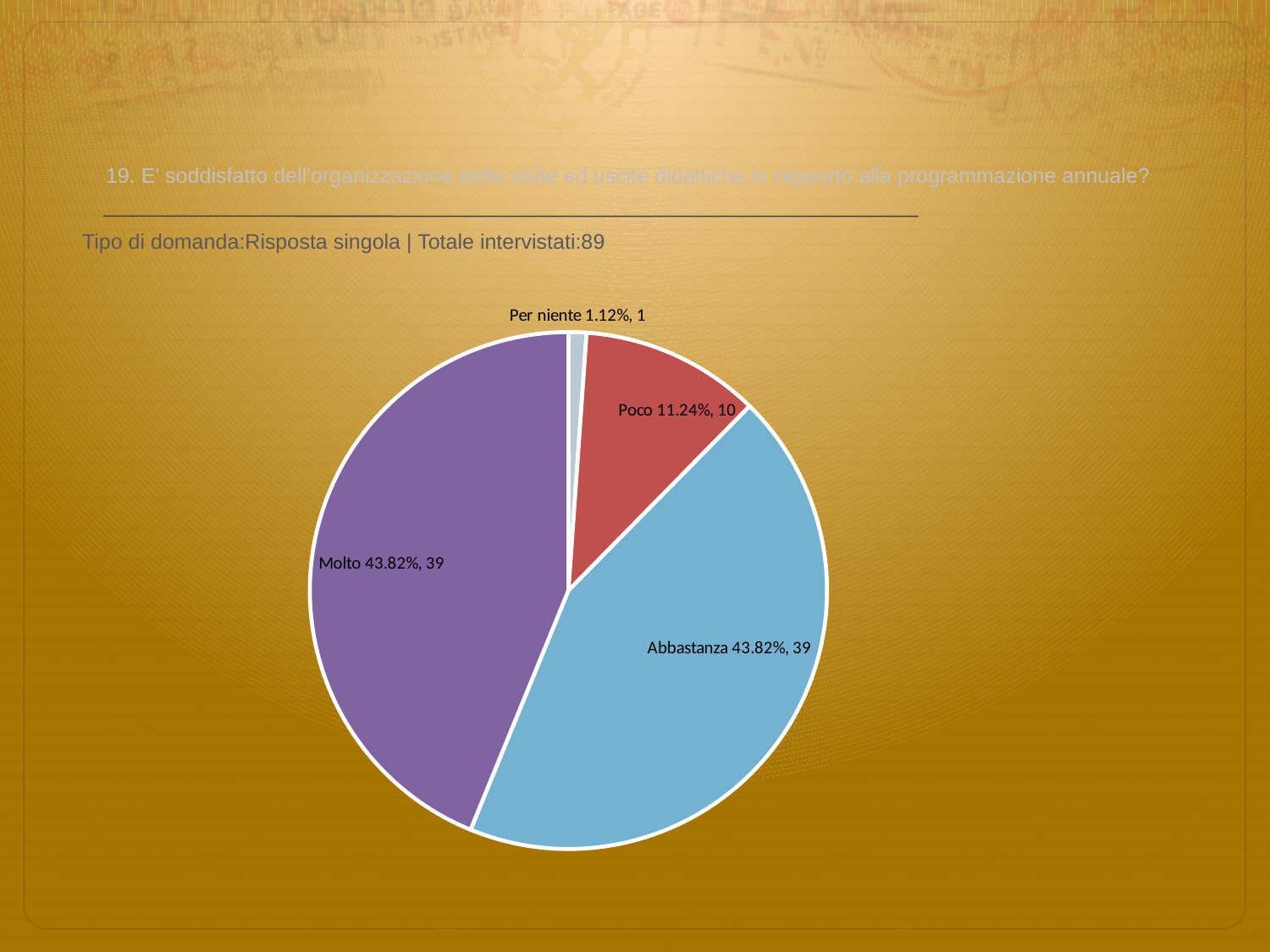
What kind of chart is shown on the slide? pie chart Which category has the smallest slice of the pie? Per niente Which is larger, the slice for "Poco" or the slice for "Per niente"? Poco What is the difference in number of respondents between "Abbastanza" and "Poco"? 29 What is the difference in number of respondents between "Poco" and "Per niente"? 9 How many respondents answered "Poco"? 10 How many slices does the pie chart have? 4 How many respondents answered "Abbastanza"? 39 What percentage of the pie does "Molto" represent? 43.82% What is the total number of respondents across all slices of the pie? 89 What colour is the "Molto" slice of the pie? purple What percentage of the pie does "Per niente" represent? 1.12%